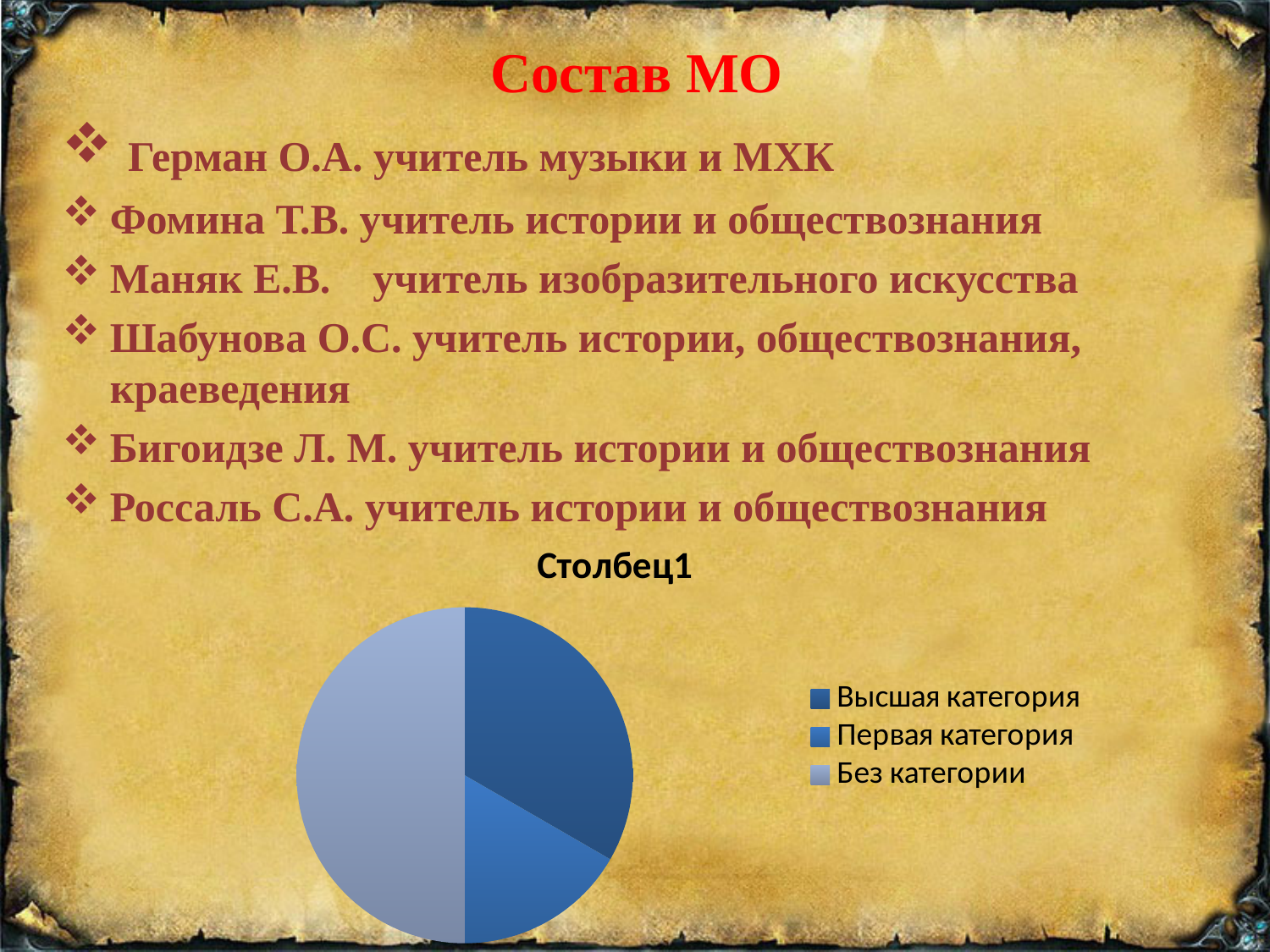
What is the title of the pie chart? Столбец1 Which slice is larger in the pie chart: Высшая категория or Первая категория? Высшая категория Which slice is larger in the pie chart: Без категории or Первая категория? Без категории Which category has the largest slice in the pie chart? Без категории Which legend entry is listed first in the pie chart's legend? Высшая категория Which slice is larger in the pie chart: Без категории or Высшая категория? Без категории Which category has the smallest slice in the pie chart? Первая категория How many slices does the pie chart have? 3 How many entries does the legend of the pie chart list? 3 What kind of chart is shown on the slide? pie chart